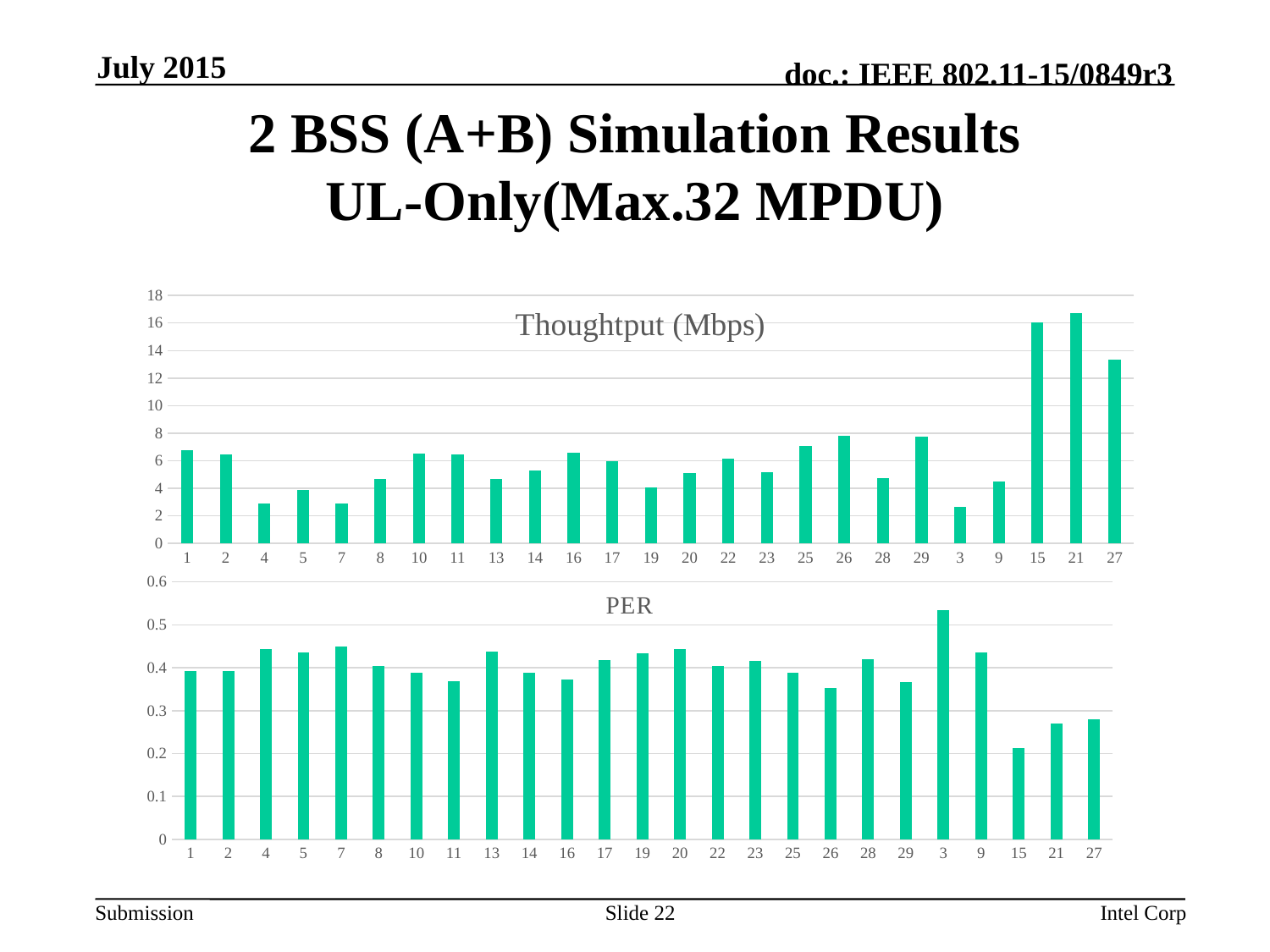
In the PER chart, which category has the lowest value? 15 In the Thoughtput (Mbps) chart, which category has the highest value? 21 In the PER chart, is the value for category 15 greater or less than 0.3? less In the Thoughtput (Mbps) chart, is the value for category 27 greater or less than 12? greater What kind of chart is the Thoughtput (Mbps) chart? bar chart How many categories are shown on the x axis of the PER chart? 25 What is the title of the lower chart on the slide? PER In the Thoughtput (Mbps) chart, which is larger, the value for category 15 or category 3? 15 In the Thoughtput (Mbps) chart, is the value for category 3 greater or less than 4? less In the PER chart, which category has the highest value? 3 In the PER chart, which is larger, the value for category 7 or category 21? 7